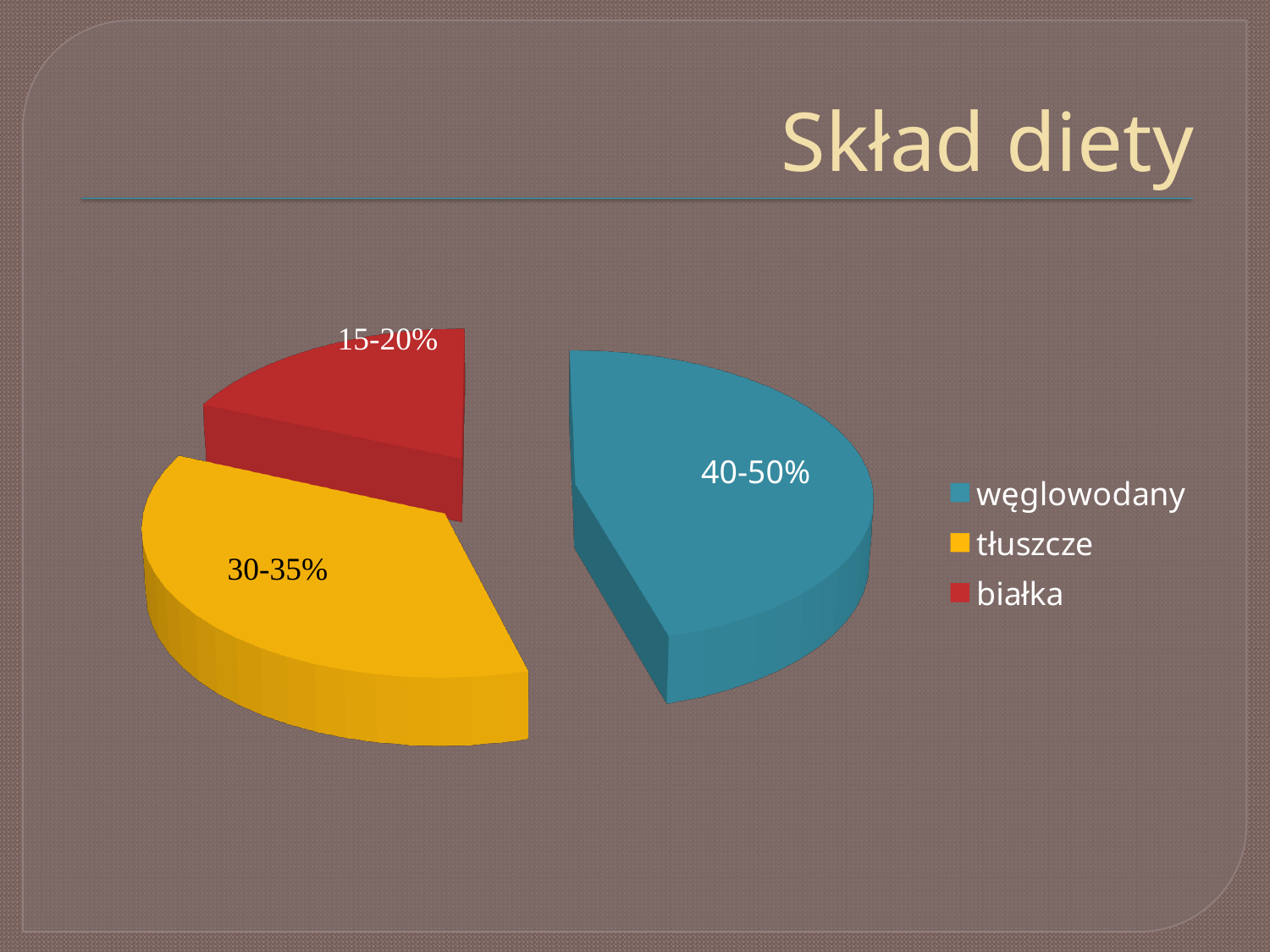
What is the label shown on the białka slice? 15-20% What is the title of the slide containing the chart? Skład diety Which slice is larger, tłuszcze or białka? tłuszcze What colour is the białka slice? red Which category has the smallest slice of the pie? białka What kind of chart is shown on the slide? pie chart What is the label shown on the węglowodany slice? 40-50% How many entries does the legend list? 3 How many slices does the pie chart have? 3 Which category has the largest slice of the pie? węglowodany Which slice is larger, węglowodany or tłuszcze? węglowodany What is the label shown on the tłuszcze slice? 30-35%